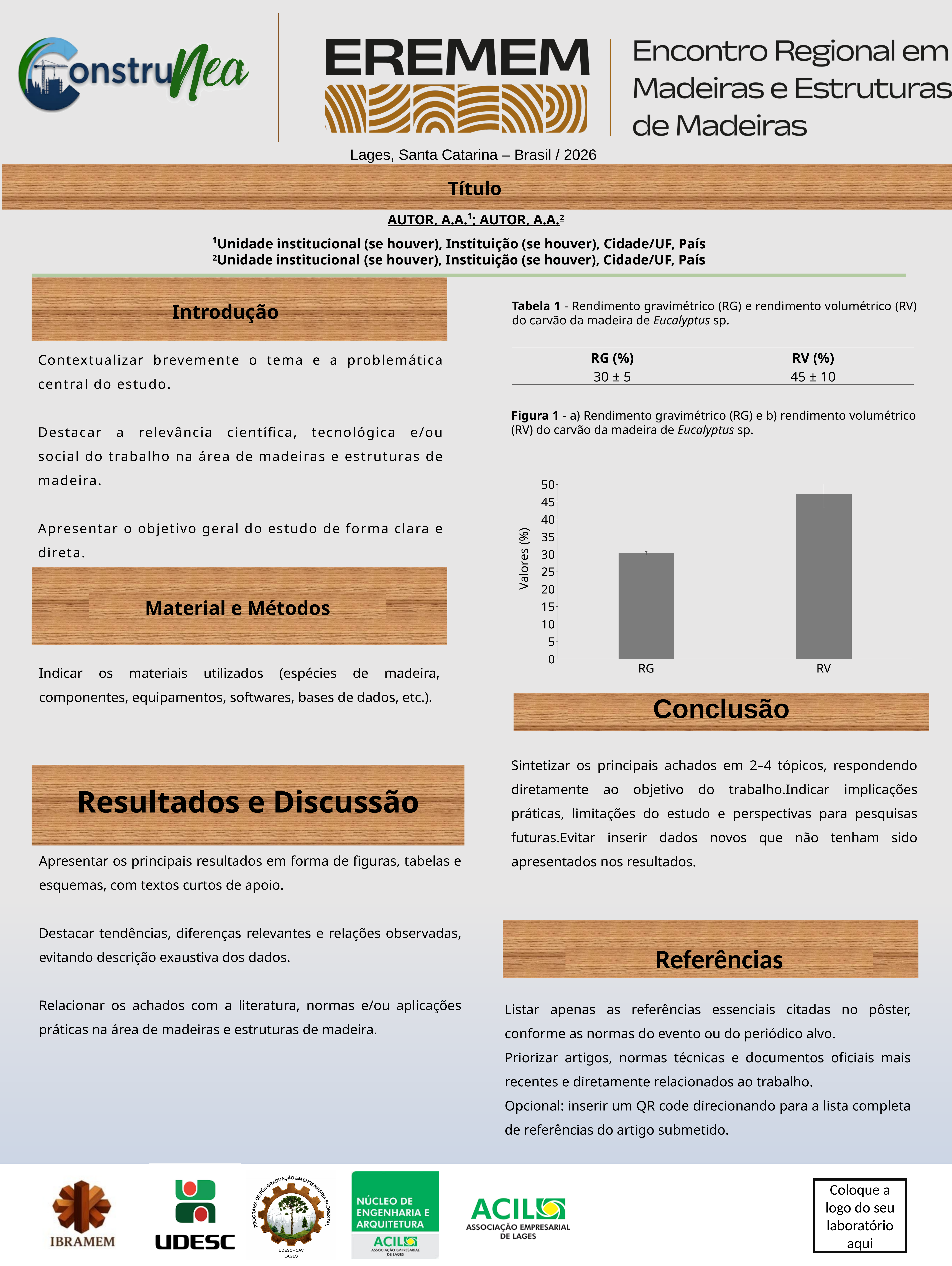
Which category has the lowest bar in the chart? RG What are the two category labels on the x axis of the chart? RG and RV Is the value for RG greater or less than 40? less Which bar is taller, RG or RV? RV Is the value for RV greater or less than 40? greater Do the bar values rise or fall from RG to RV along the x axis? rise Is the value for RV greater or less than 35? greater What is the label on the y axis of the chart? Valores (%) How many bars are plotted in the chart? 2 Which category has the highest bar in the chart? RV What kind of chart is shown in Figura 1? bar chart